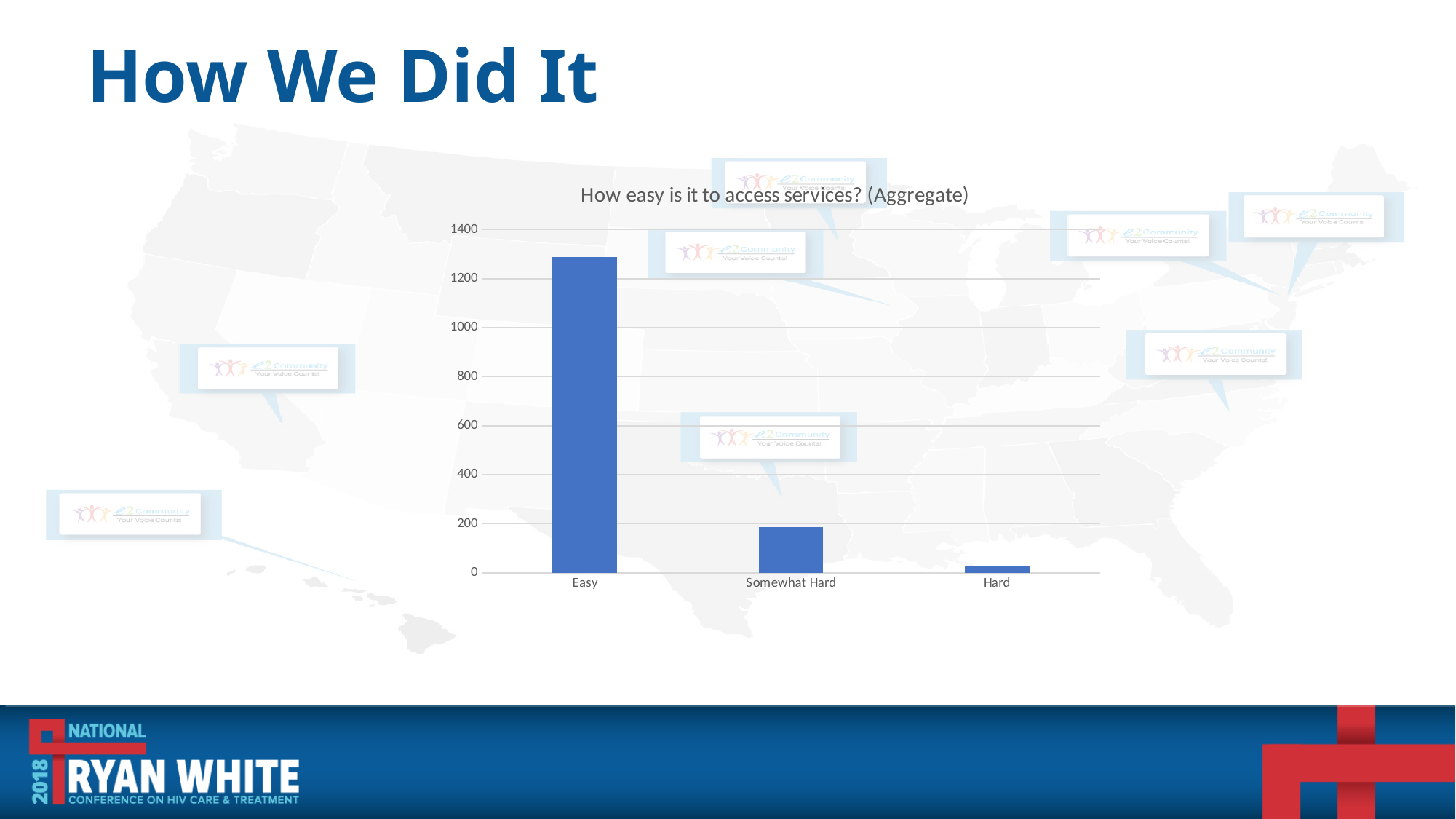
Is the value for Somewhat Hard greater or less than 200? less Which category has the highest value in the chart? Easy Which category has the lowest value in the chart? Hard Is the value for Easy greater or less than 1200? greater What is the title of the chart? How easy is it to access services? (Aggregate) Which is larger, the value for Easy or the value for Somewhat Hard? Easy Is the value for Hard greater or less than 200? less What is the highest value shown on the chart's vertical axis? 1400 What kind of chart is shown on the slide? bar chart Do the values rise or fall moving from Easy to Hard along the x axis? fall Which is larger, the value for Somewhat Hard or the value for Hard? Somewhat Hard How many categories are shown on the x axis of the chart? 3